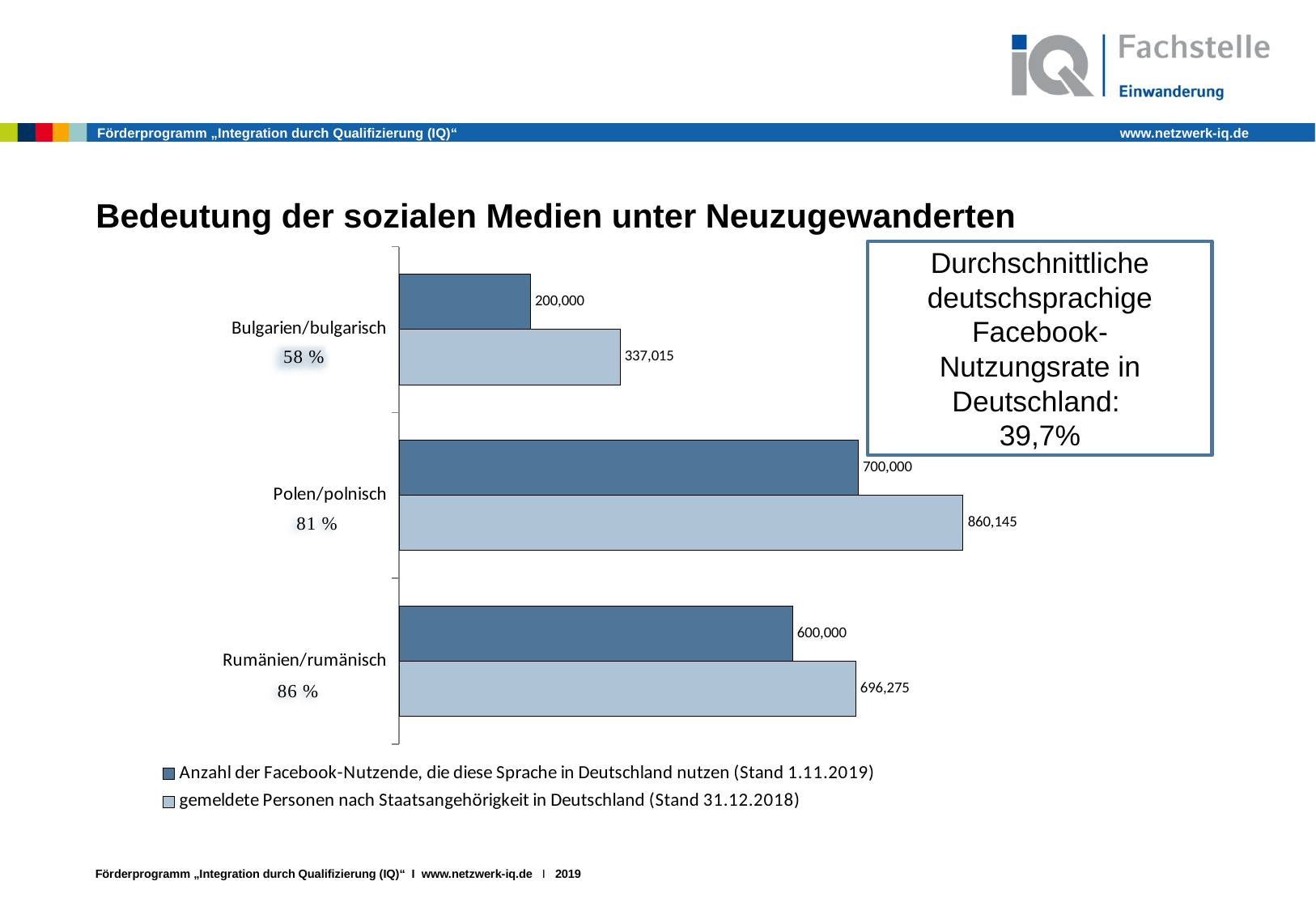
How many categories (countries/languages) does the chart show? 3 What kind of chart is shown on the slide? bar chart What is the number of registered persons by nationality in Germany for Rumänien/rumänisch? 696,275 What percentage is shown under the Rumänien/rumänisch label? 86 % What is the number of registered persons by nationality in Germany for Bulgarien/bulgarisch? 337,015 What is the average German-language Facebook usage rate in Germany stated in the box on the slide? 39,7% Which category has the lowest number of registered persons by nationality? Bulgarien/bulgarisch What is the difference between the registered persons and the Facebook users for Polen/polnisch? 160,145 Which is larger for Rumänien/rumänisch: the number of Facebook users or the number of registered persons? registered persons (696,275) How many series does the legend list? 2 Which category has the highest number of Facebook users? Polen/polnisch What is the number of Facebook users who use the language in Germany for Polen/polnisch? 700,000